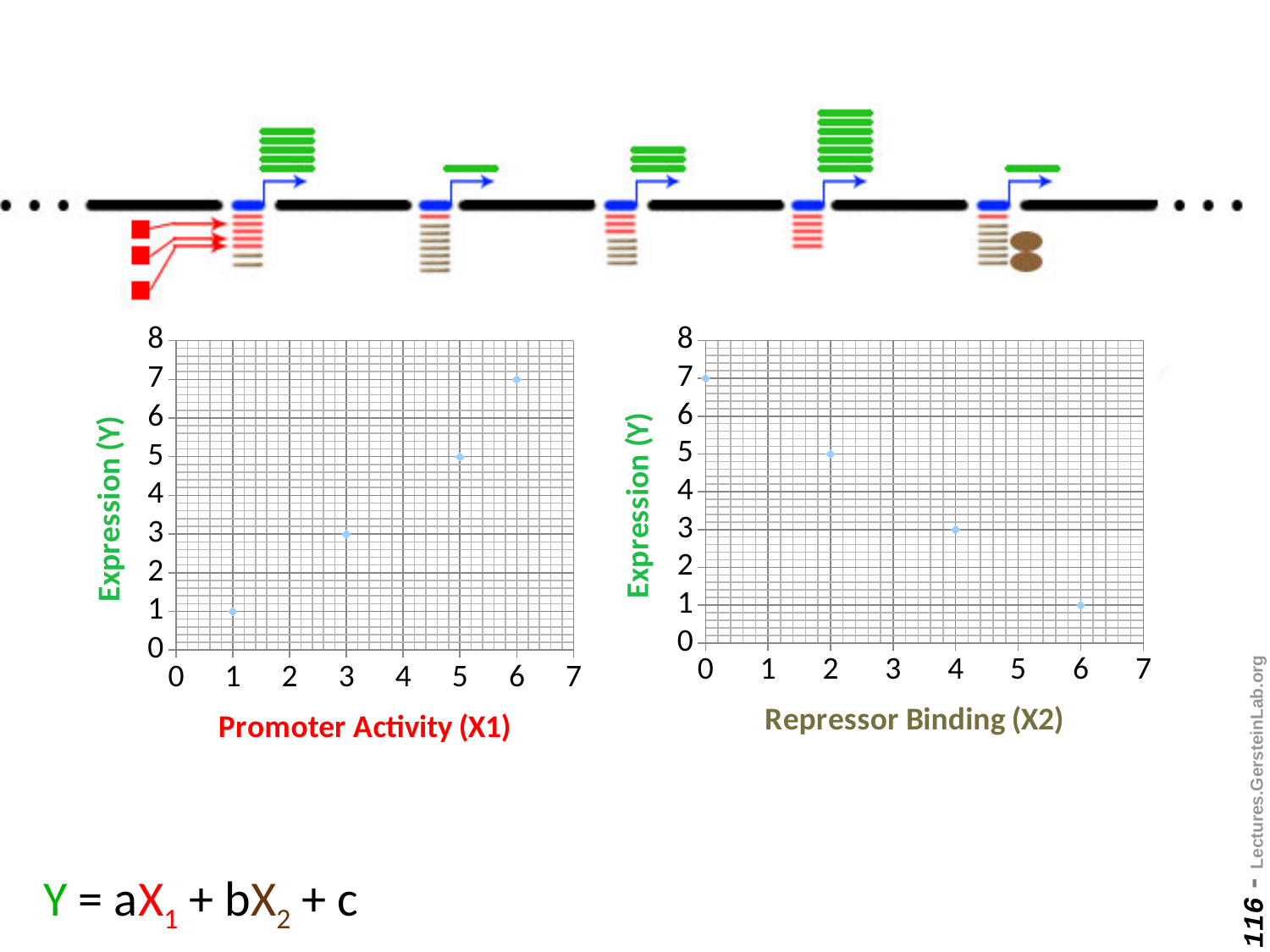
How many data points are plotted on the left chart (Promoter Activity (X1))? 4 On the right chart, what is the Expression (Y) value at Repressor Binding (X2) = 6? 1 On the left chart, do the Expression (Y) values rise or fall as Promoter Activity (X1) increases? rise On the left chart, which Promoter Activity (X1) value has the lowest Expression (Y)? 1 On the right chart, what is the Expression (Y) value at Repressor Binding (X2) = 0? 7 On the right chart, what is the difference in Expression (Y) between Repressor Binding (X2) = 0 and Repressor Binding (X2) = 6? 6 On the left chart, what is the Expression (Y) value at Promoter Activity (X1) = 3? 3 What kind of chart is the left chart, with x axis Promoter Activity (X1)? scatter chart How many data points are plotted on the right chart (Repressor Binding (X2))? 4 On the right chart, do the Expression (Y) values rise or fall as Repressor Binding (X2) increases? fall What is the x-axis label of the right chart? Repressor Binding (X2) On the left chart, what is the Expression (Y) value at Promoter Activity (X1) = 6? 7